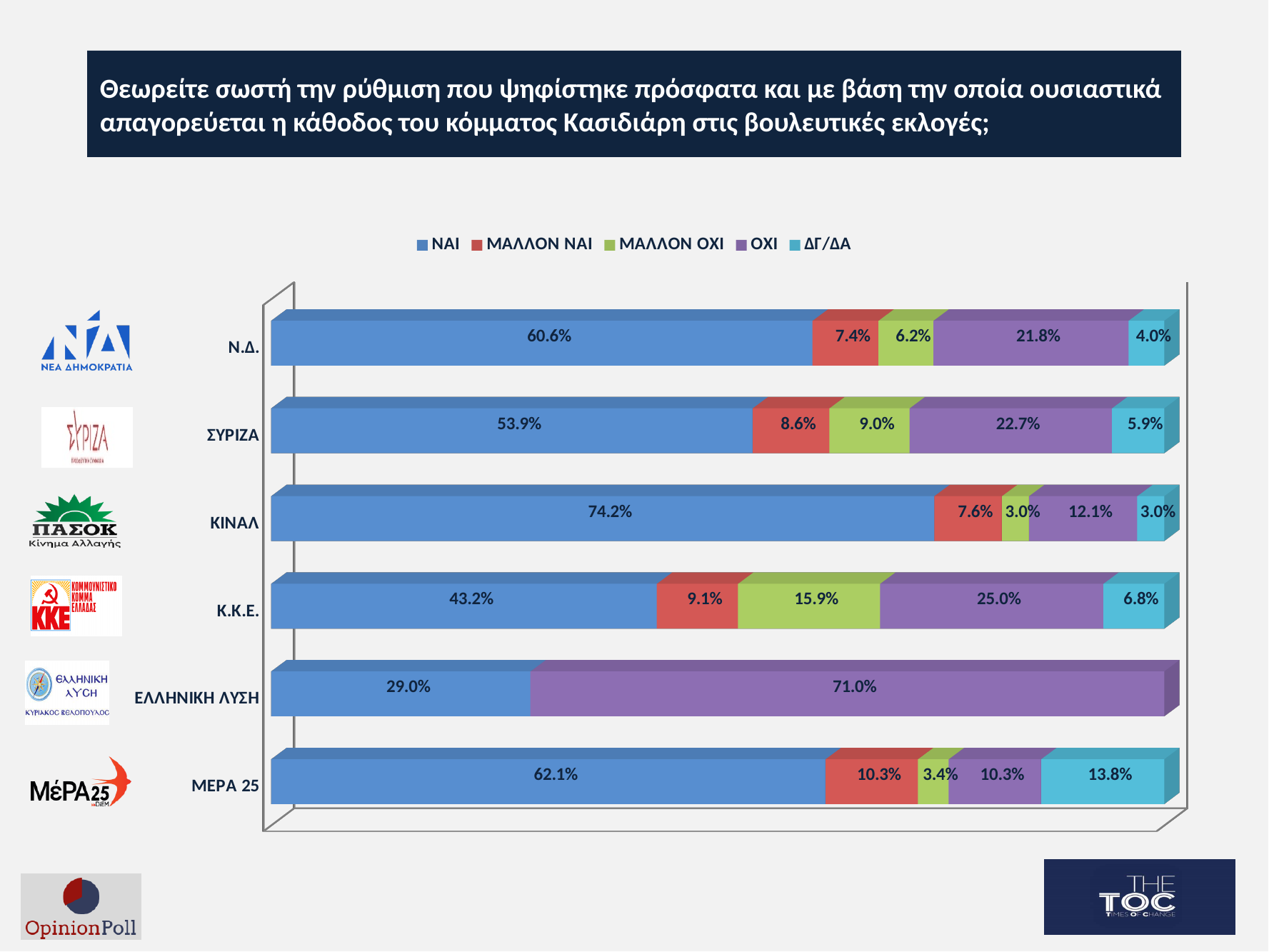
Which party has the highest ΝΑΙ value? ΚΙΝΑΛ What is the ΟΧΙ value for ΕΛΛΗΝΙΚΗ ΛΥΣΗ? 71.0% Which is larger: the ΟΧΙ value for Κ.Κ.Ε. or the ΟΧΙ value for ΣΥΡΙΖΑ? Κ.Κ.Ε. What is the ΔΓ/ΔΑ value for ΜΕΡΑ 25? 13.8% What type of chart is shown on the slide? Stacked bar chart Which party has the lowest ΝΑΙ value? ΕΛΛΗΝΙΚΗ ΛΥΣΗ What is the ΝΑΙ value for ΚΙΝΑΛ? 74.2% How many series does the legend list? 5 What is the difference between the ΝΑΙ values of Ν.Δ. and ΣΥΡΙΖΑ? 6.7% What is the ΜΑΛΛΟΝ ΟΧΙ value for Κ.Κ.Ε.? 15.9% How many parties (categories) are shown in the chart? 6 Which series is shown in purple in the legend? ΟΧΙ